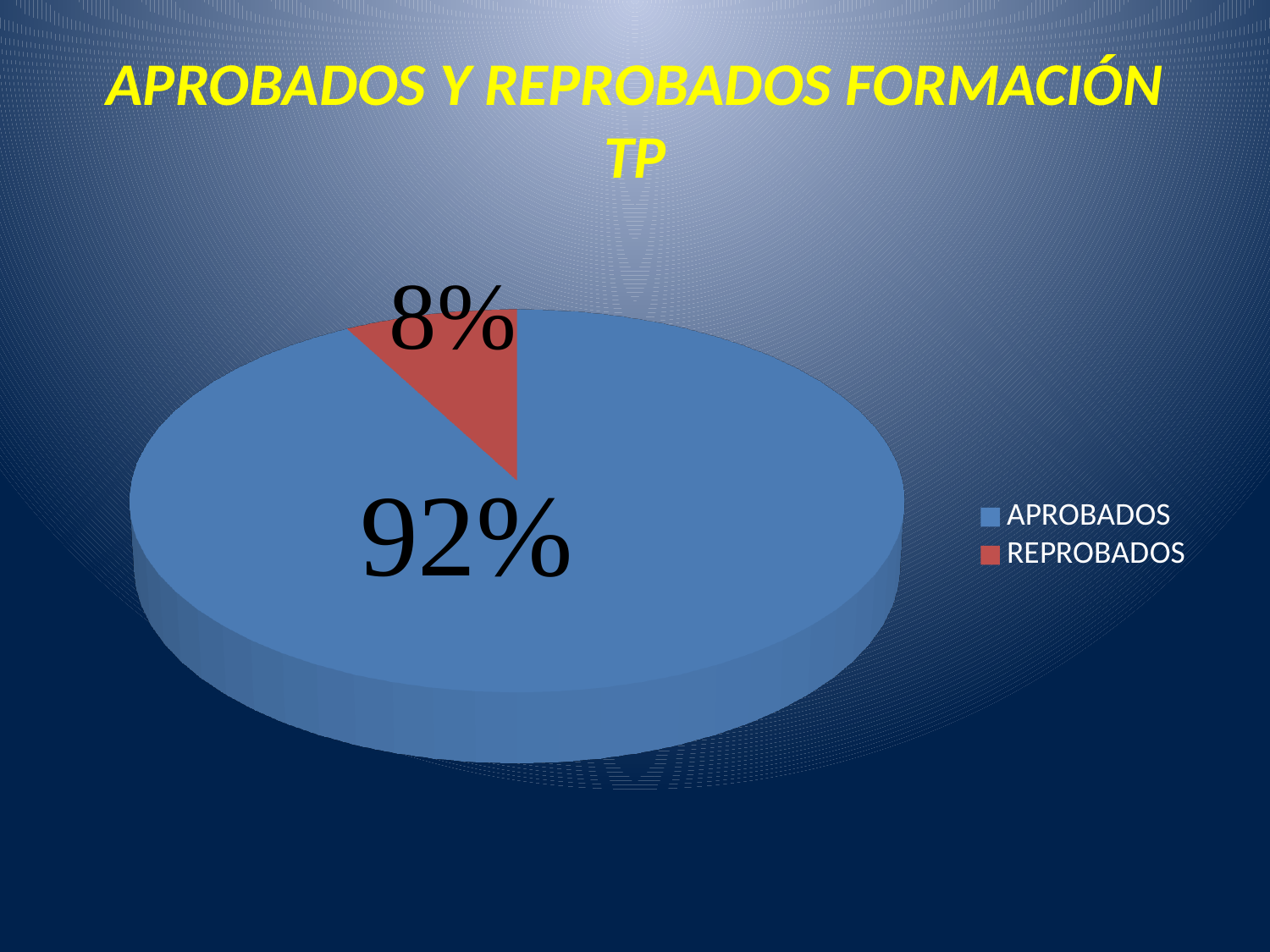
What percentage of the pie is REPROBADOS? 8% Which category has the smallest share of the pie? REPROBADOS Which is larger, the share for APROBADOS or the share for REPROBADOS? APROBADOS How many entries does the legend list? 2 What kind of chart is shown on the slide? Pie chart What percentage of the pie is APROBADOS? 92% What share of the pie does the REPROBADOS slice represent? 8% What colour is the REPROBADOS slice? Red What is the title of the chart? APROBADOS Y REPROBADOS FORMACIÓN TP What is the difference in percentage points between APROBADOS and REPROBADOS? 84 How many categories does the pie chart show? 2 Which category has the largest share of the pie? APROBADOS